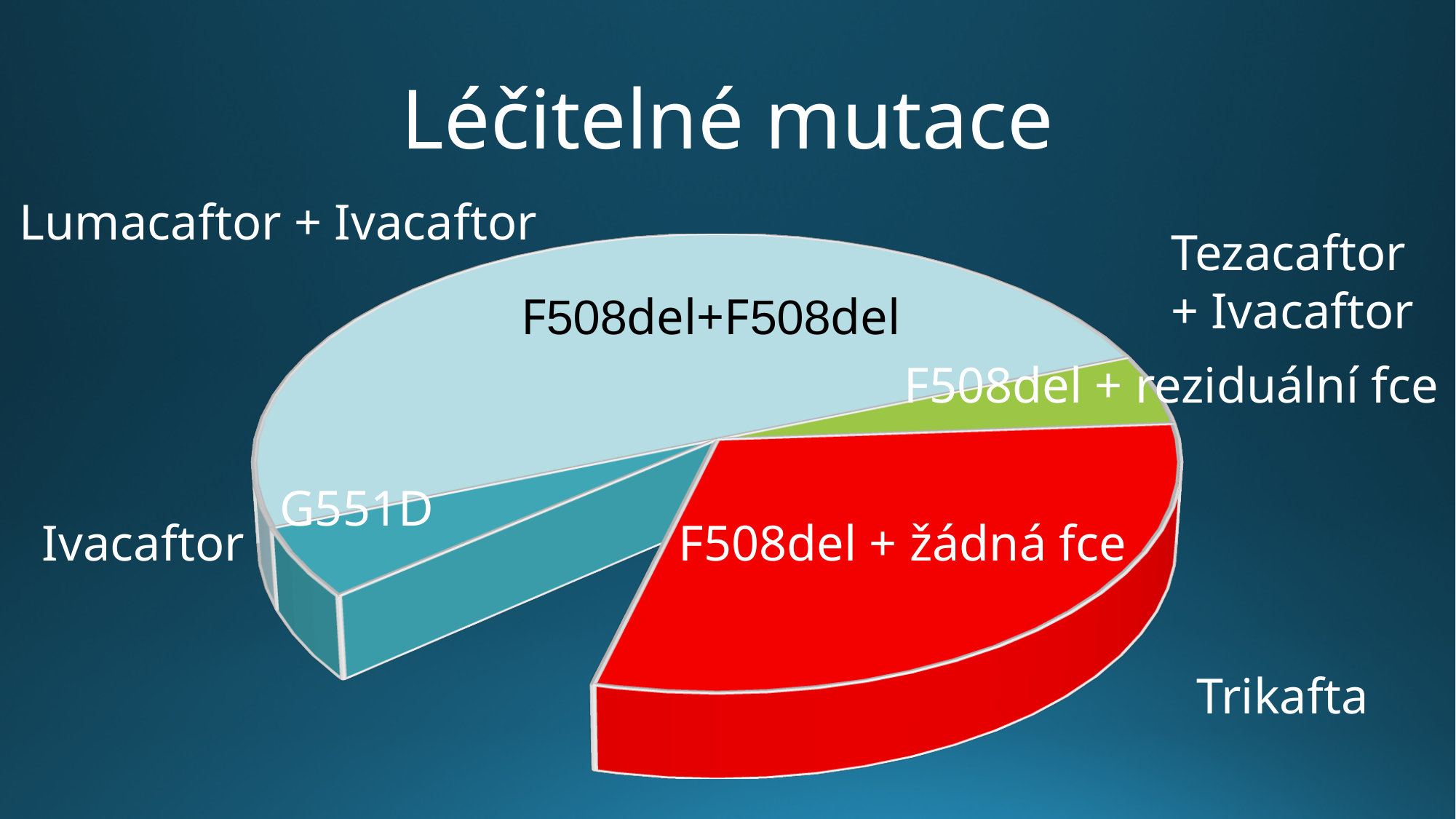
Which slice of the pie chart is the largest? F508del+F508del How many slices does the pie chart have? 5 What colour is the F508del + žádná fce slice of the pie chart? red What is the title of the slide with the pie chart? Léčitelné mutace What kind of chart is shown on the slide? pie chart Which slice is larger, F508del + žádná fce or F508del + reziduální fce? F508del + žádná fce Which slice is larger, F508del + žádná fce or G551D? F508del + žádná fce Which slice is larger, F508del+F508del or G551D? F508del+F508del